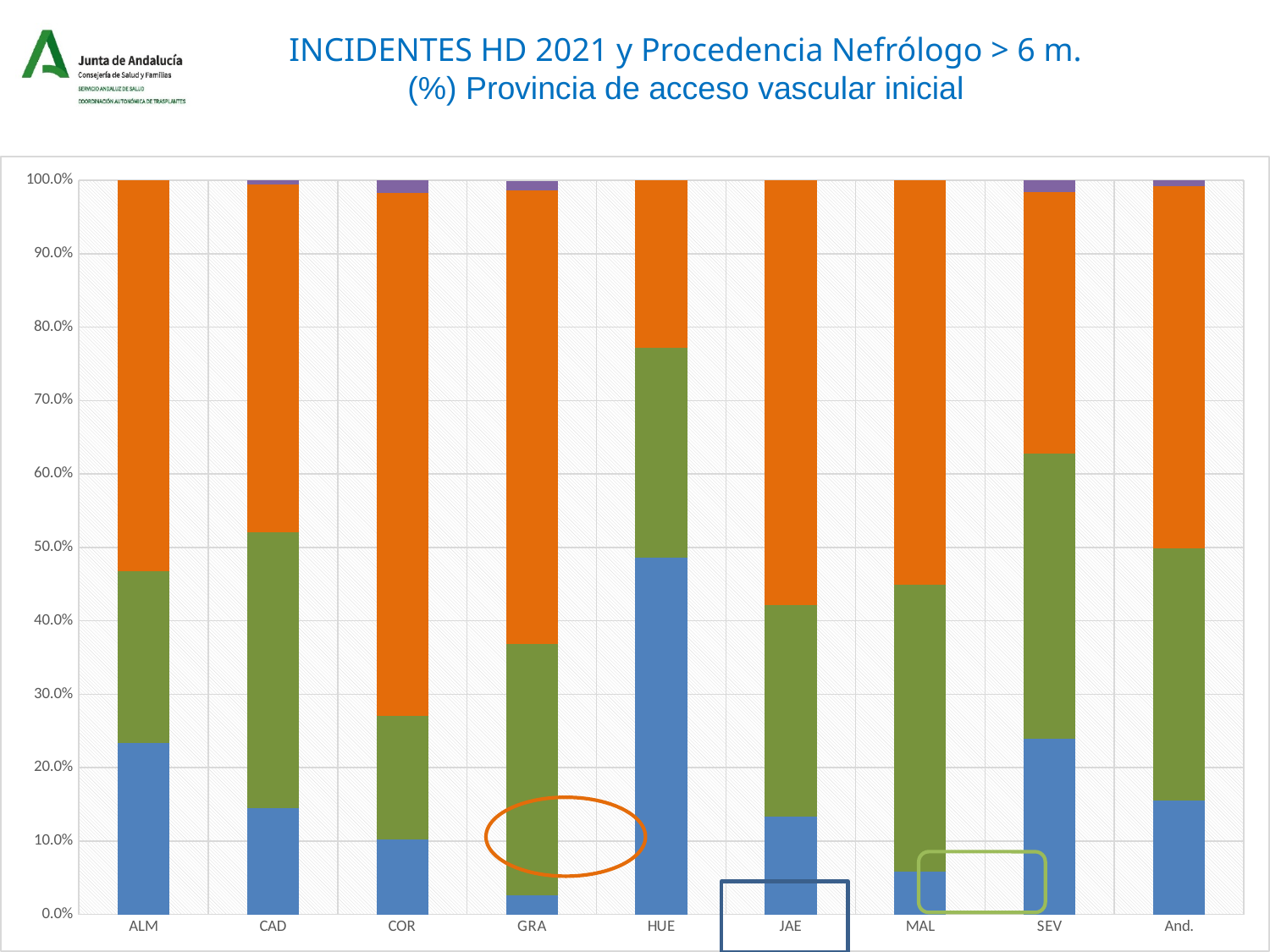
Does the top of the green segment for HUE lie above or below 70.0%? above What kind of chart is shown on the slide? Stacked bar chart Is the blue segment for HUE greater or less than 40.0%? greater Which category has the tallest blue (bottom) segment? HUE Is the blue segment for GRA greater or less than 10.0%? less Which has the larger blue segment, SEV or JAE? SEV Which has the larger blue segment, ALM or CAD? ALM Which category has the shortest blue (bottom) segment? GRA What is the first line of the slide title? INCIDENTES HD 2021 y Procedencia Nefrólogo > 6 m. How many categories are shown along the x axis of the chart? 9